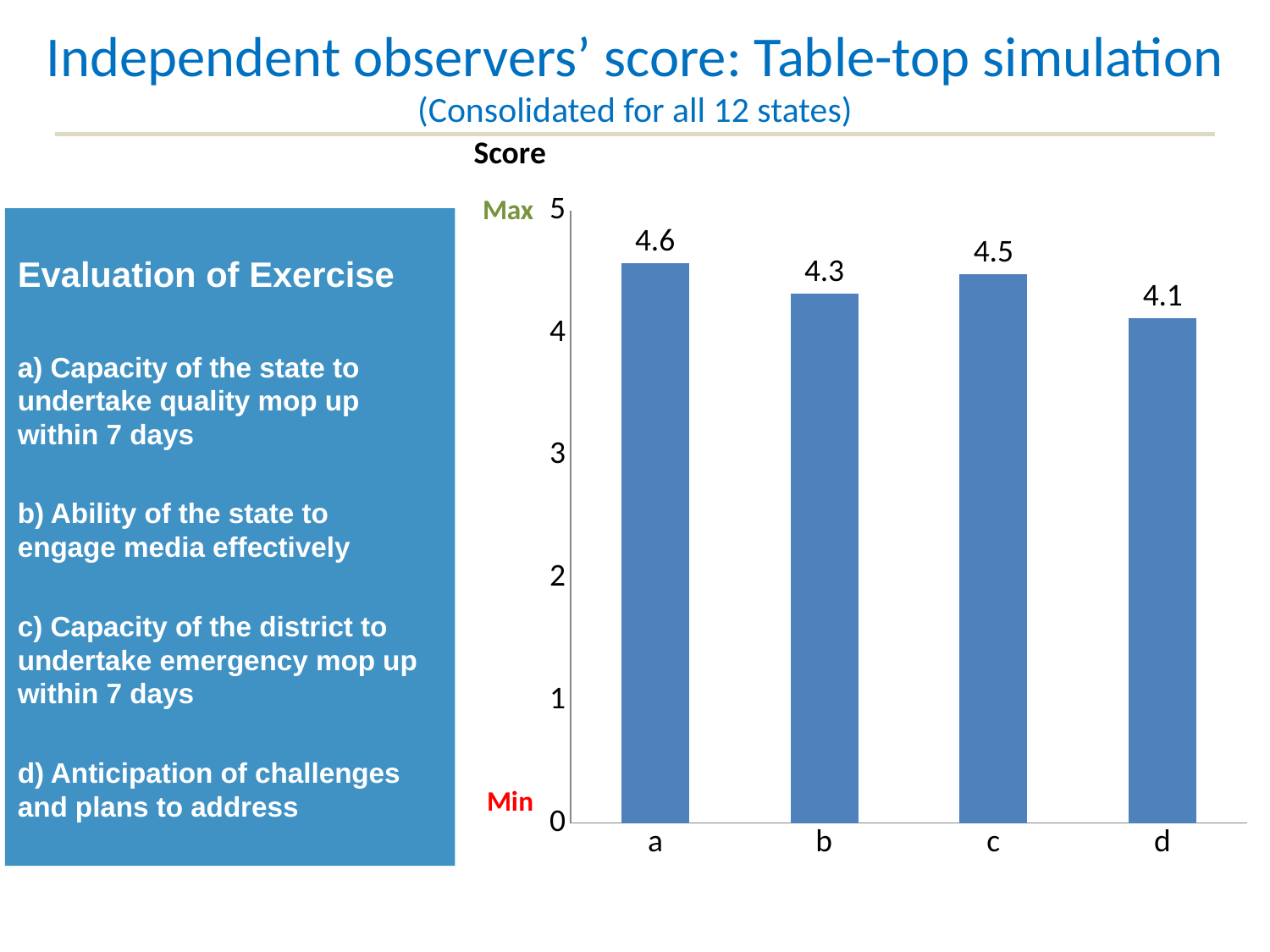
What is the difference between the scores for a and d? 0.5 Which has a higher score, b or c? c Which category has the lowest score? d What is the score for category d? 4.1 What is the score for category a? 4.6 Which category has the highest score? a What kind of chart is shown on the slide? bar chart What is the score for category c? 4.5 How many categories are shown on the x axis? 4 What is the maximum value shown on the y axis? 5 Is the score for d greater or less than 4? greater What is the score for category b? 4.3